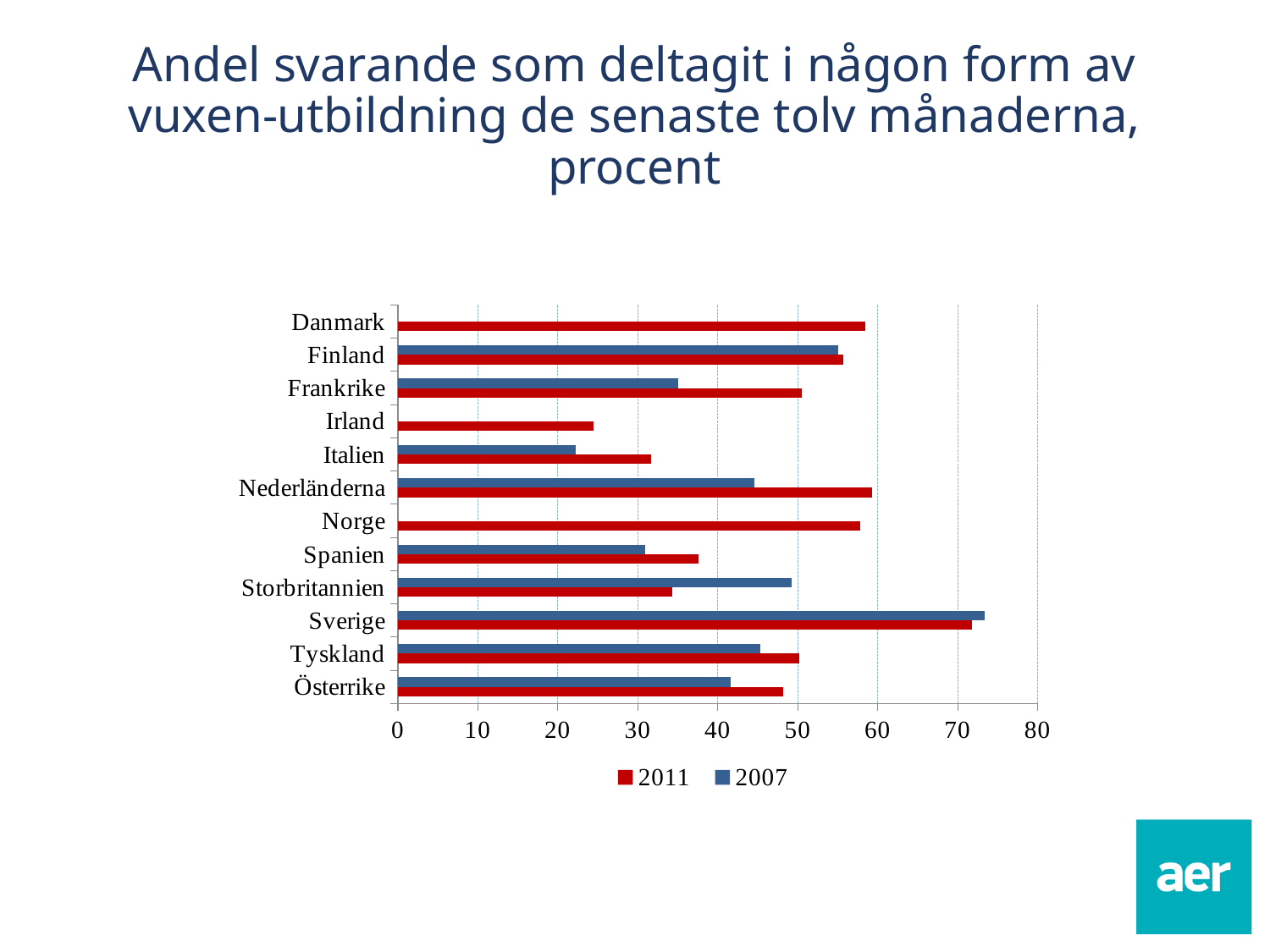
Which country has the lowest value for 2007 among those with a 2007 bar? Italien Which country has the highest value for 2011? Sverige What kind of chart is shown on the slide? bar chart How many countries are listed on the vertical axis of the chart? 12 For Frankrike, which year has the larger value, 2007 or 2011? 2011 Is the 2011 value for Sverige greater or less than 70? greater Which colour represents the 2007 series in the legend? blue For Storbritannien, which year has the larger value, 2007 or 2011? 2007 Is the 2011 value for Irland greater or less than 30? less How many series does the legend list? 2 Which country has the lowest value for 2011? Irland Which country has the highest value for 2007? Sverige